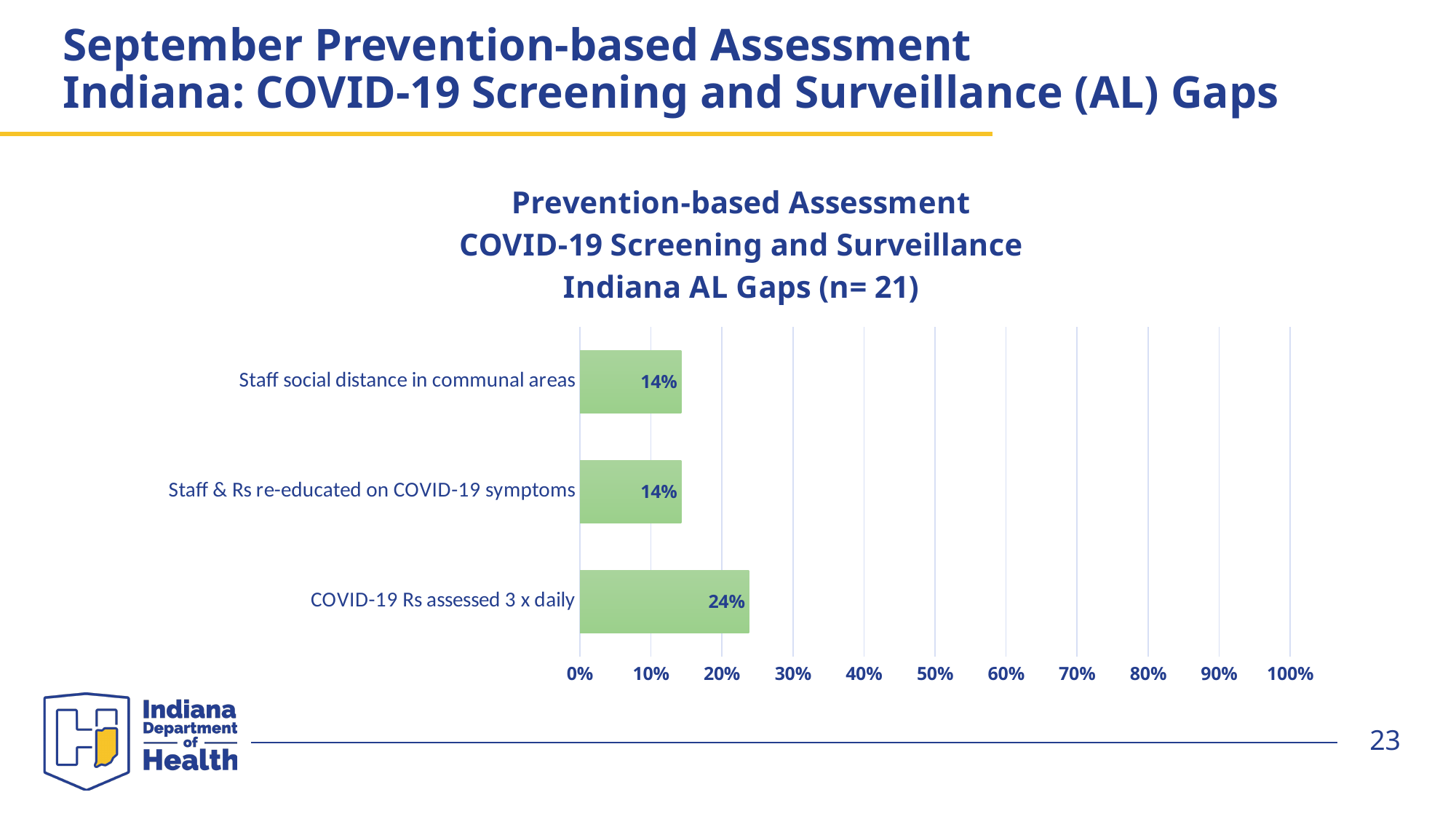
What is the sample size (n) given in the chart title? 21 What is the value for "Staff & Rs re-educated on COVID-19 symptoms"? 14% What is the difference between the value for "COVID-19 Rs assessed 3 x daily" and the value for "Staff social distance in communal areas"? 10% What kind of chart is shown on the slide? Bar chart Is the value for "Staff social distance in communal areas" greater or less than 20%? less Which category has the highest value? COVID-19 Rs assessed 3 x daily Which is larger: the value for "COVID-19 Rs assessed 3 x daily" or the value for "Staff & Rs re-educated on COVID-19 symptoms"? COVID-19 Rs assessed 3 x daily How many categories are shown in the chart? 3 What is the value for "COVID-19 Rs assessed 3 x daily"? 24% Is the value for "COVID-19 Rs assessed 3 x daily" greater or less than 20%? greater What is the maximum value shown on the x axis? 100% What is the value for "Staff social distance in communal areas"? 14%